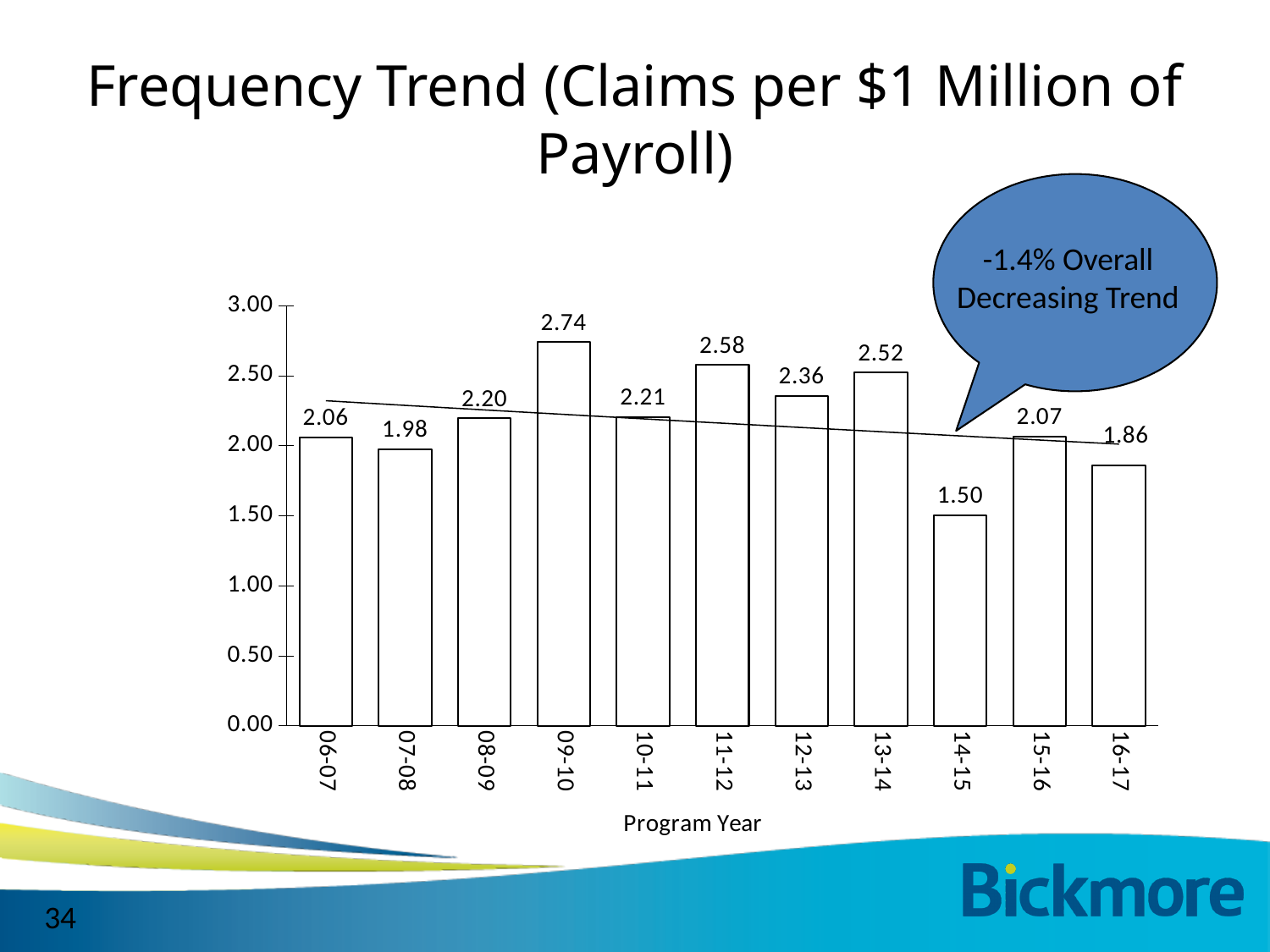
What is the value for program year 14-15? 1.50 Which program year has the highest value? 09-10 What kind of chart is shown on the slide? bar chart What is the value for program year 16-17? 1.86 What overall trend does the callout on the chart describe? -1.4% Overall Decreasing Trend Which program year has the lowest value? 14-15 What is the x-axis title of the chart? Program Year Which is larger, the value for 11-12 or the value for 13-14? 11-12 How many program years are shown on the x axis? 11 What is the difference between the values for 09-10 and 14-15? 1.24 What is the value for program year 09-10? 2.74 Is the value for 12-13 greater or less than 2.00? greater